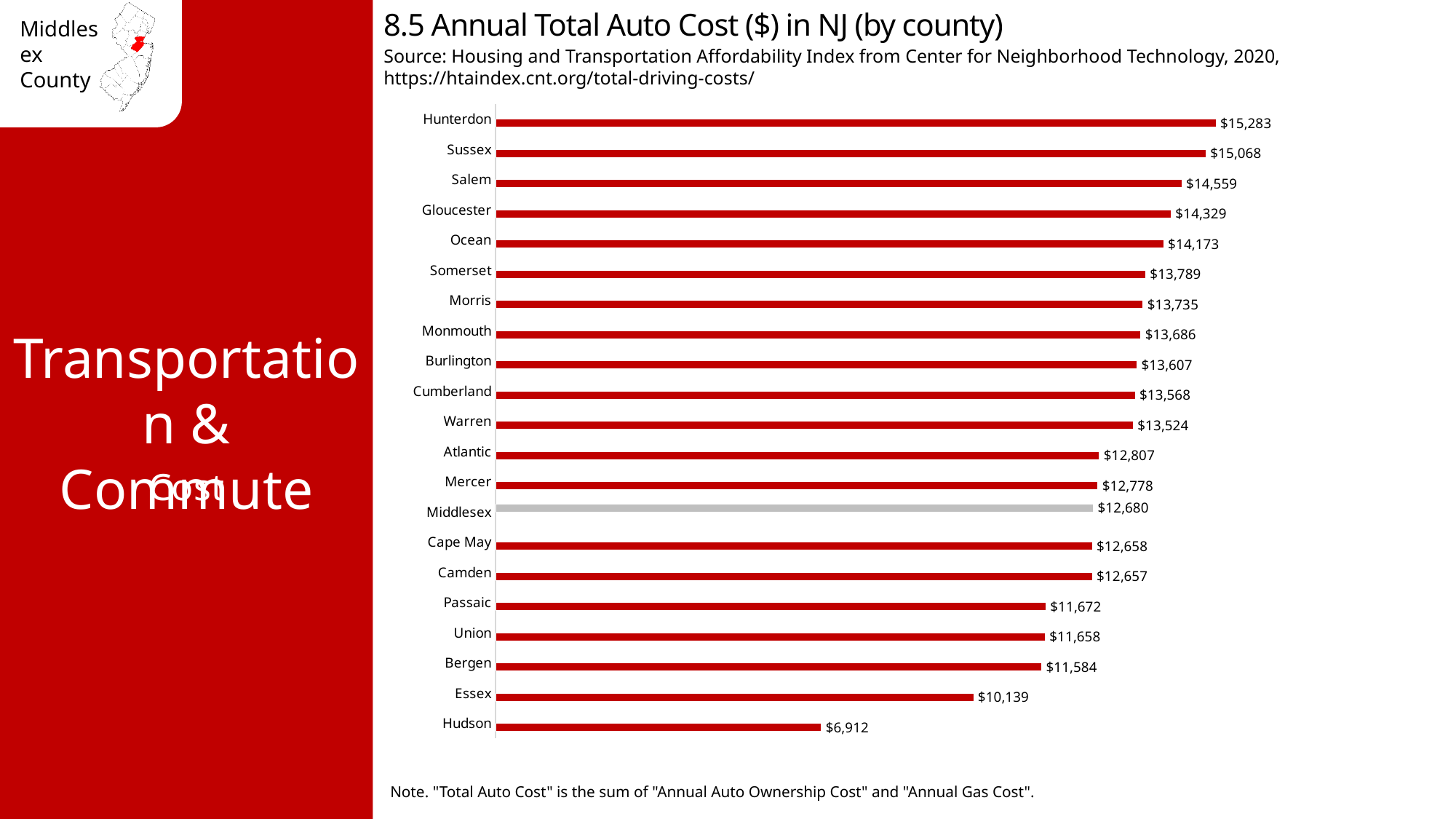
What is the annual total auto cost for Hudson County? $6,912 What is the annual total auto cost for Ocean County? $14,173 Which county has a higher annual total auto cost, Bergen or Atlantic? Atlantic Which county's bar is shown in gray instead of red? Middlesex Which county has the lowest annual total auto cost? Hudson What is the difference in annual total auto cost between Middlesex and Essex? $2,541 What is the source of the data shown in the chart? Housing and Transportation Affordability Index from Center for Neighborhood Technology, 2020 How many counties are shown in the chart? 21 What type of chart is used to show annual total auto cost by county? Bar chart Which county has the highest annual total auto cost? Hunterdon What is the difference in annual total auto cost between Hunterdon and Hudson? $8,371 What is the annual total auto cost for Middlesex County? $12,680